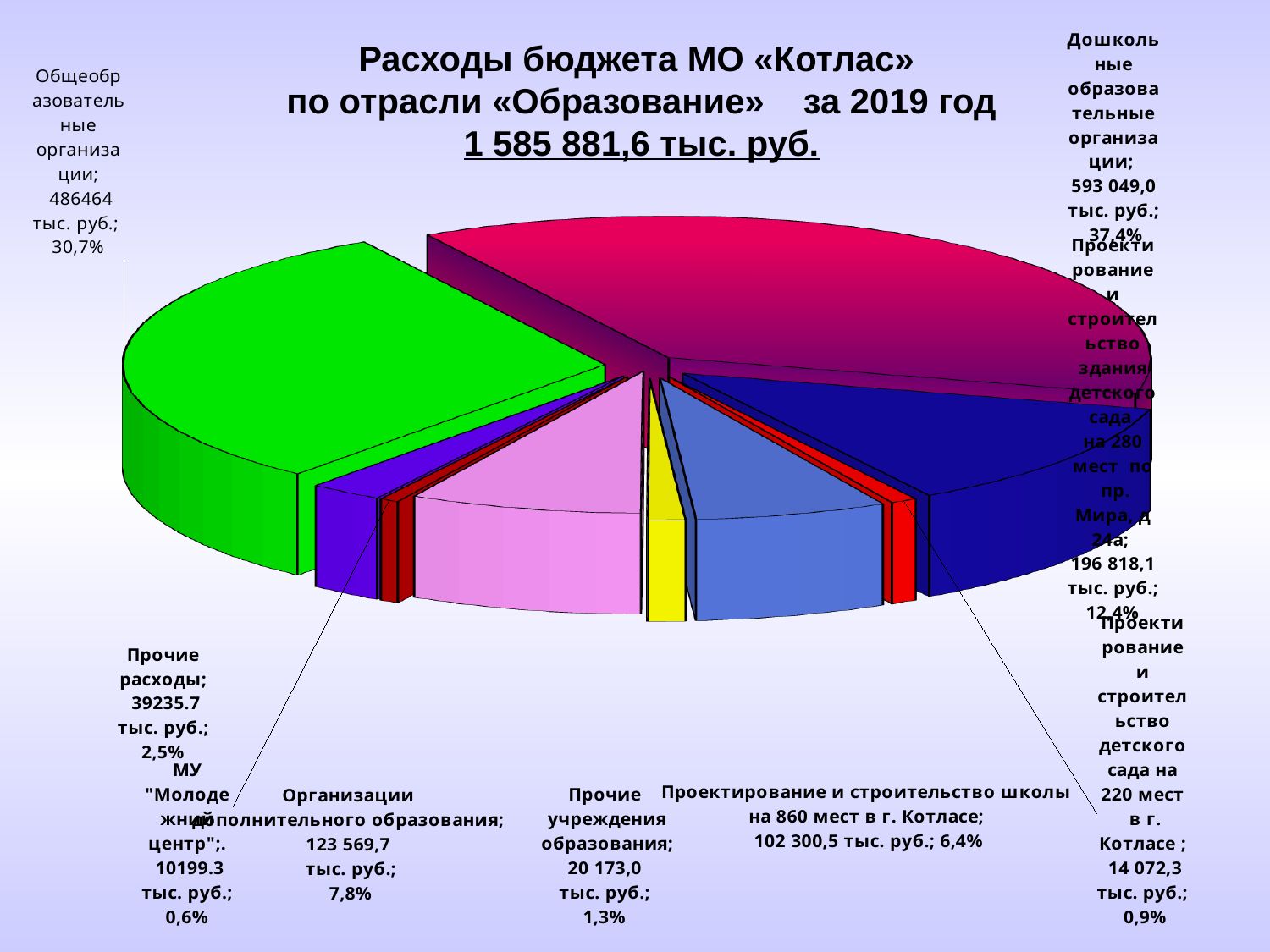
What percentage is shown for «Проектирование и строительство школы на 860 мест в г. Котласе»? 6,4% How many slices does the pie chart have? 9 What total amount is stated in the chart title? 1 585 881,6 тыс. руб. What is the value for «Проектирование и строительство детского сада на 220 мест в г. Котласе»? 14 072,3 тыс. руб. What is the value for «Организации дополнительного образования»? 123 569,7 тыс. руб. Which category has the largest share of the pie? Дошкольные образовательные организации What share of the pie does «Общеобразовательные организации» represent? 30,7% What is the difference in percentage points between «Дошкольные образовательные организации» (37,4%) and «Общеобразовательные организации» (30,7%)? 6,7 Which category has the smallest share of the pie? МУ "Молодежний центр" What kind of chart is shown on the slide? pie chart Which is larger: the share for «Прочие расходы» or the share for «Прочие учреждения образования»? Прочие расходы What is the value for «Дошкольные образовательные организации»? 593 049,0 тыс. руб.